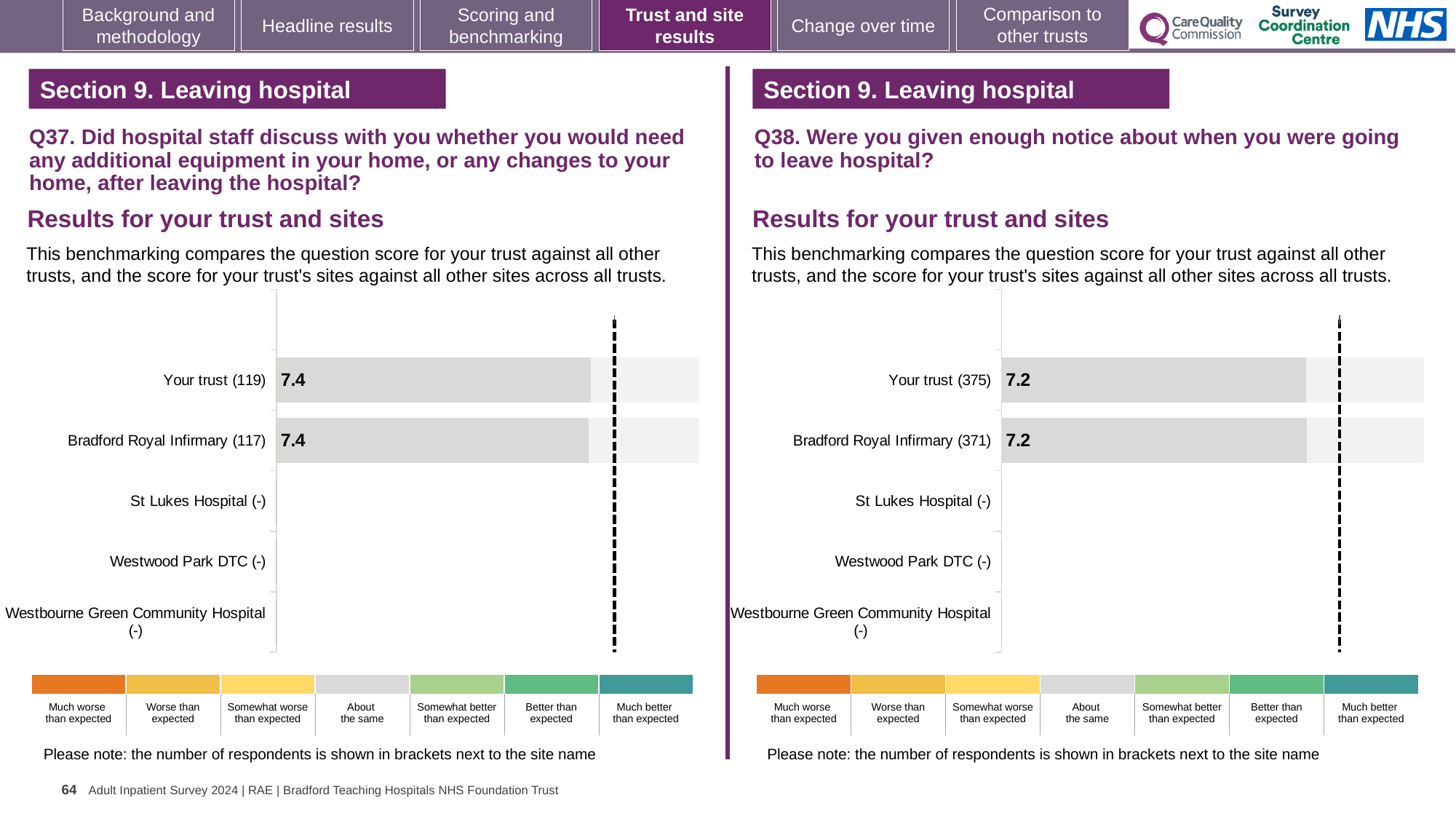
In the Q37 chart on the left, what is the difference between the score for Your trust and the score for Bradford Royal Infirmary? 0.0 In the Q38 chart on the right, what is the score for Bradford Royal Infirmary (371)? 7.2 In the Q37 chart on the left, what is the score for Your trust (119)? 7.4 In the Q37 chart on the left, what is the score for Bradford Royal Infirmary (117)? 7.4 How many site/trust categories are listed on the y axis of the Q37 chart on the left? 5 In the Q38 chart on the right, how many respondents are shown in brackets for Your trust? 375 How many site/trust categories are listed on the y axis of the Q38 chart on the right? 5 In the Q38 chart on the right, what is the difference between the score for Your trust and the score for Bradford Royal Infirmary? 0.0 In the Q38 chart on the right, what is the score for Your trust (375)? 7.2 In the Q37 chart on the left, how many respondents are shown in brackets for Bradford Royal Infirmary? 117 What kind of chart is used for the Q37 results on the left? Bar chart How many benchmark categories are shown in the colour legend below the Q38 chart on the right? 7